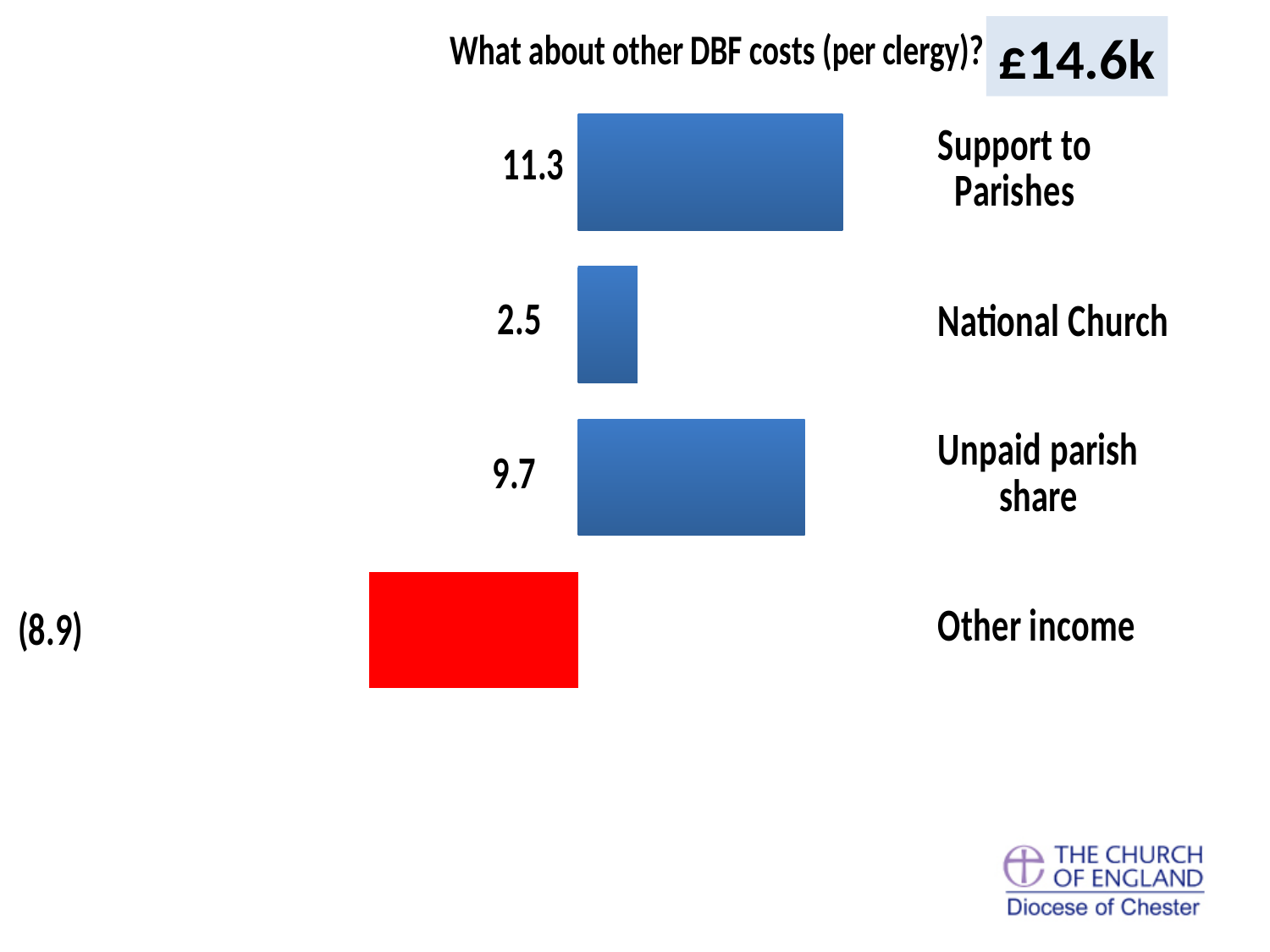
How many categories are shown in the chart? 4 Which is larger, the value for Support to Parishes or the value for Unpaid parish share? Support to Parishes What is the value for Support to Parishes? 11.3 Which category has the highest value? Support to Parishes What is the difference between the values for Unpaid parish share and National Church? 7.2 Which category has the smallest positive bar? National Church What kind of chart is shown on the slide? Bar chart What is the value shown for Other income? (8.9) What is the value for Unpaid parish share? 9.7 Which category is shown with a red bar? Other income What is the value for National Church? 2.5 What is the difference between the values for Support to Parishes and Unpaid parish share? 1.6